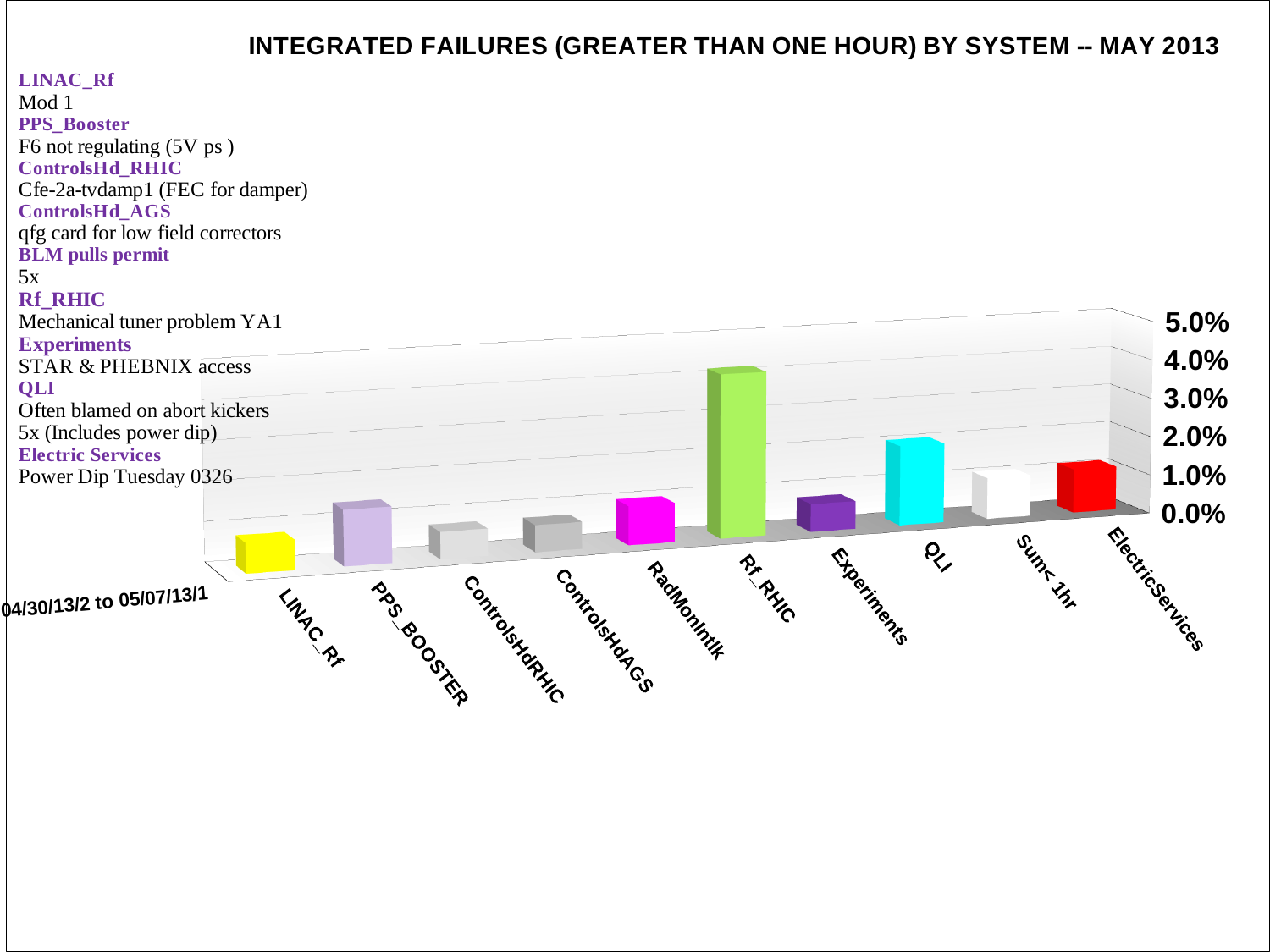
How many system categories are plotted along the x axis of the chart? 10 What is the highest value shown on the chart's vertical axis? 5.0% Which is larger, the value for Rf_RHIC or the value for QLI? Rf_RHIC Is the value for QLI greater or less than 1.0%? greater Which system has the highest bar in the chart? Rf_RHIC Is the value for LINAC_Rf greater or less than 1.0%? less Is the value for Experiments greater or less than 1.0%? less Which is larger, the value for ElectricServices or the value for ControlsHdRHIC? ElectricServices What is the title of the chart? INTEGRATED FAILURES (GREATER THAN ONE HOUR) BY SYSTEM -- MAY 2013 What kind of chart is shown on the slide? bar chart Which is larger, the value for QLI or the value for PPS_BOOSTER? QLI